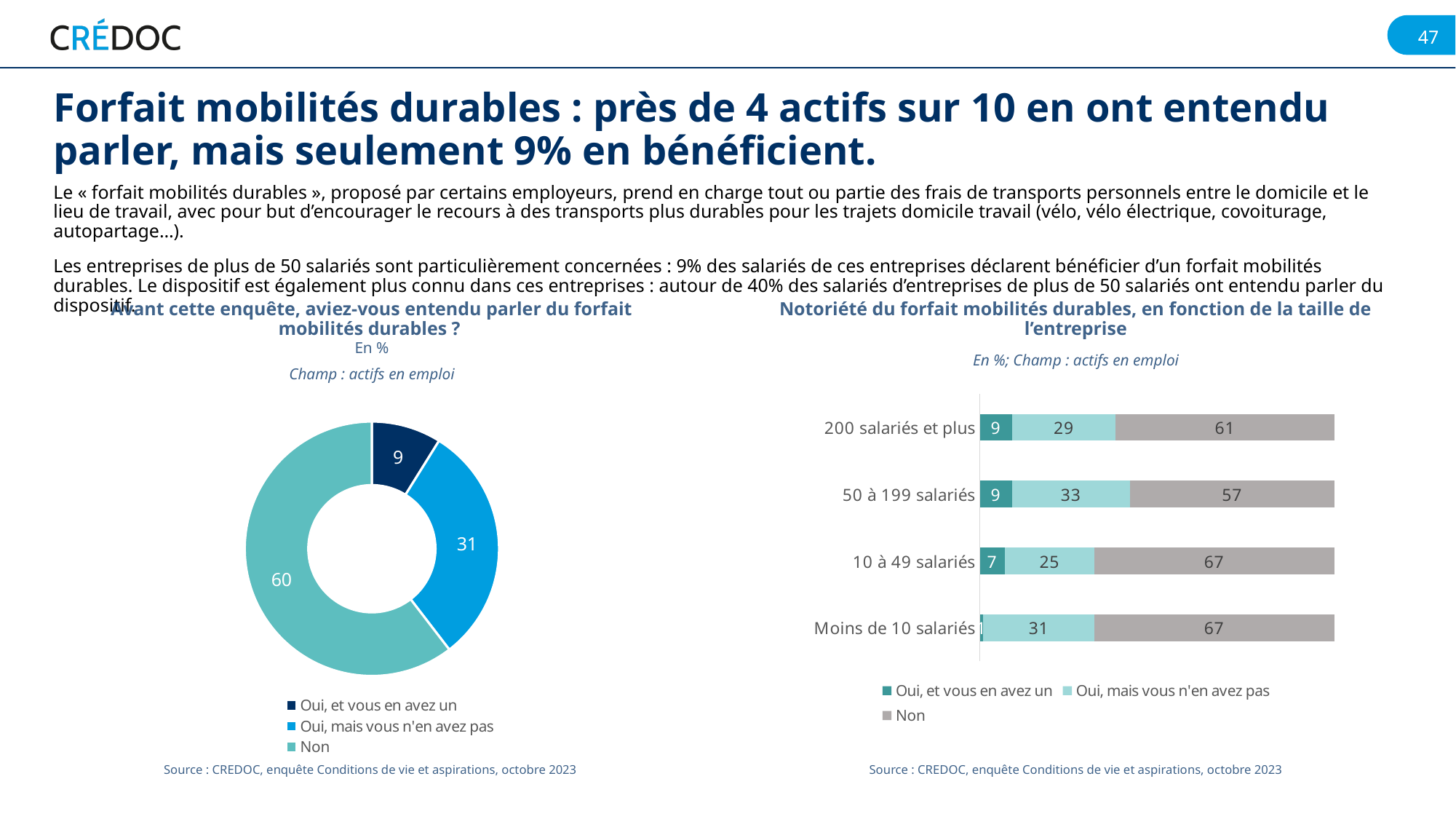
In the right chart ("Notoriété du forfait mobilités durables, en fonction de la taille de l'entreprise"), what is the value of "Non" for "50 à 199 salariés"? 57 In the left chart ("Avant cette enquête, aviez-vous entendu parler du forfait mobilités durables ?"), what is the value for "Oui, mais vous n'en avez pas"? 31 In the left chart ("Avant cette enquête, aviez-vous entendu parler du forfait mobilités durables ?"), which category has the smallest share? Oui, et vous en avez un In the left chart ("Avant cette enquête, aviez-vous entendu parler du forfait mobilités durables ?"), how many categories does the legend list? 3 In the right chart ("Notoriété du forfait mobilités durables, en fonction de la taille de l'entreprise"), how many series does the legend list? 3 In the right chart ("Notoriété du forfait mobilités durables, en fonction de la taille de l'entreprise"), what is the difference between the "Non" values for "10 à 49 salariés" and "200 salariés et plus"? 6 In the left chart ("Avant cette enquête, aviez-vous entendu parler du forfait mobilités durables ?"), what kind of chart is shown? Pie chart (donut) In the right chart ("Notoriété du forfait mobilités durables, en fonction de la taille de l'entreprise"), what kind of chart is shown? Stacked bar chart In the right chart ("Notoriété du forfait mobilités durables, en fonction de la taille de l'entreprise"), which company size has the highest value for "Oui, mais vous n'en avez pas"? 50 à 199 salariés In the right chart ("Notoriété du forfait mobilités durables, en fonction de la taille de l'entreprise"), what is the value of "Oui, et vous en avez un" for "10 à 49 salariés"? 7 In the right chart ("Notoriété du forfait mobilités durables, en fonction de la taille de l'entreprise"), what is the value of "Oui, mais vous n'en avez pas" for "200 salariés et plus"? 29 In the left chart ("Avant cette enquête, aviez-vous entendu parler du forfait mobilités durables ?"), what is the value for "Non"? 60